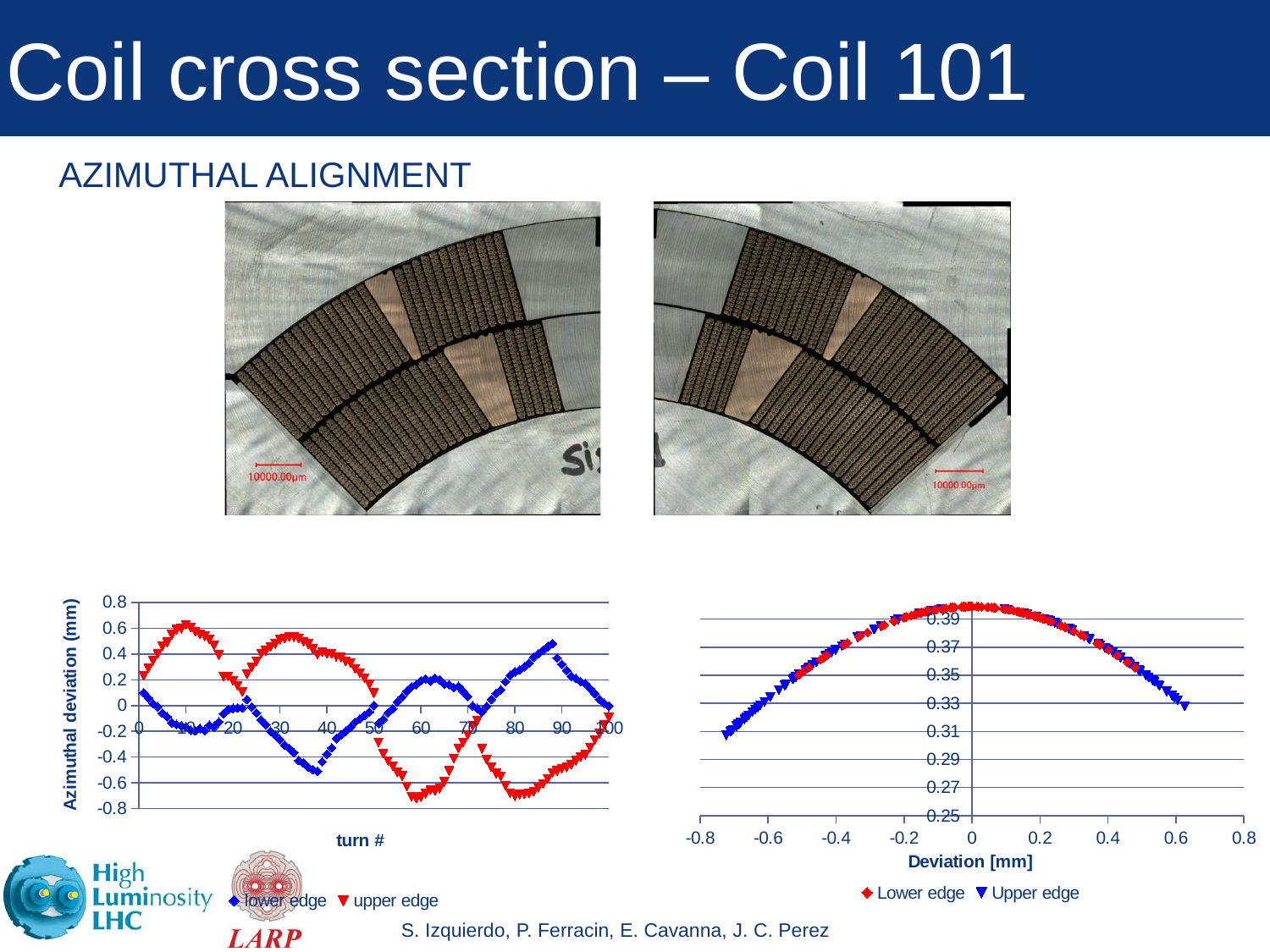
In the right chart (Deviation [mm]), do the values rise or fall as the deviation increases from 0.2 to 0.6? fall In the left chart (Azimuthal deviation vs turn #), is the upper edge value at turn 55 greater or less than -0.4? less How many series does the legend of the right chart (Deviation [mm]) list? 2 In the left chart (Azimuthal deviation vs turn #), what is the title of the vertical axis? Azimuthal deviation (mm) In the left chart (Azimuthal deviation vs turn #), is the upper edge value at turn 10 greater or less than 0.4? greater In the left chart (Azimuthal deviation vs turn #), is the lower edge value at turn 50 greater or less than -0.2? greater What kind of chart is the left chart (Azimuthal deviation vs turn #)? scatter chart What kind of chart is the right chart (Deviation [mm])? scatter chart In the left chart (Azimuthal deviation vs turn #), what is the largest tick value shown on the horizontal axis? 100 How many series does the legend of the left chart (Azimuthal deviation vs turn #) list? 2